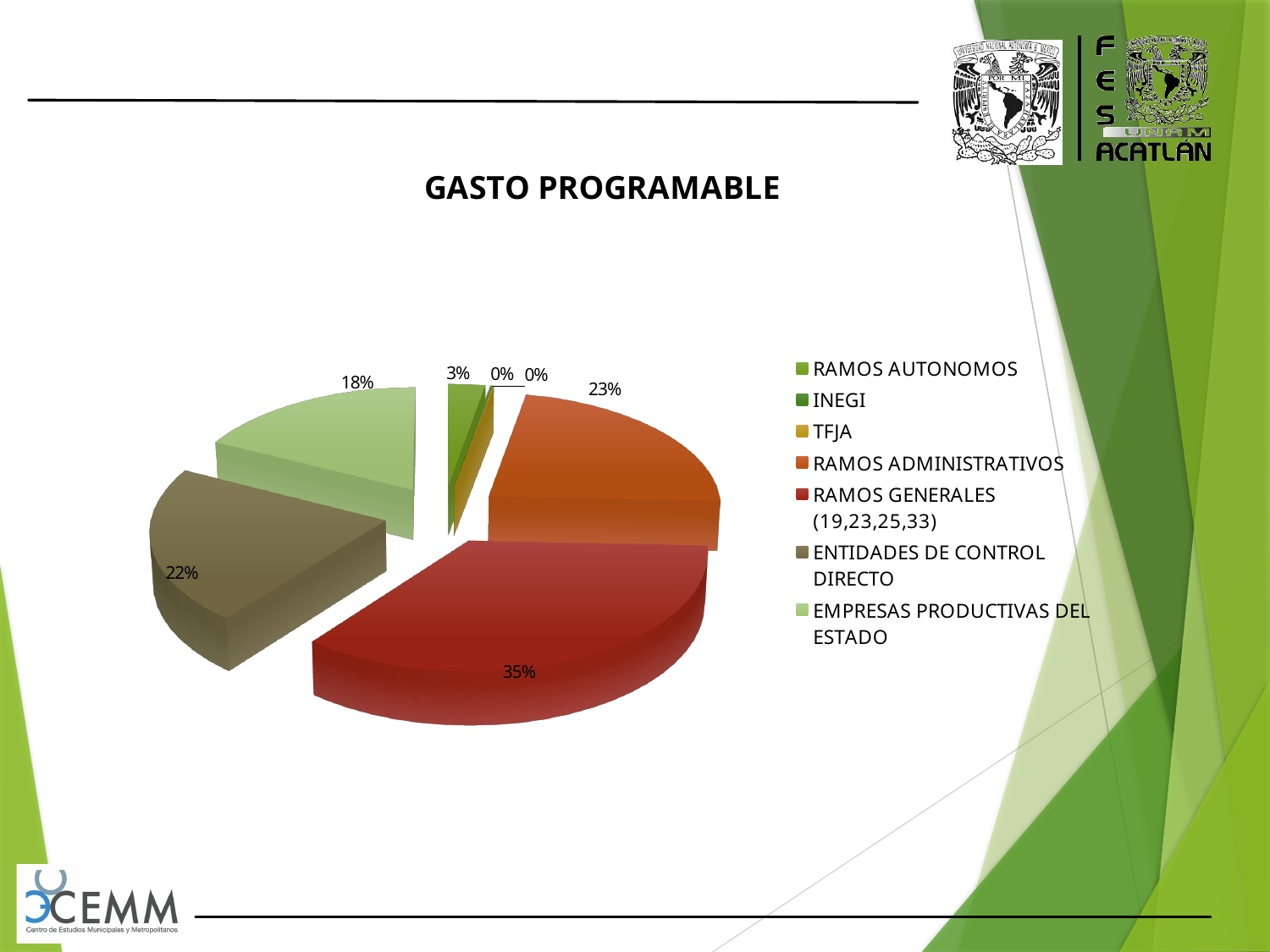
What share of the pie does EMPRESAS PRODUCTIVAS DEL ESTADO represent? 18% What share of the pie does RAMOS GENERALES (19,23,25,33) represent? 35% What is the title of the chart? GASTO PROGRAMABLE Which category has the largest share of the pie? RAMOS GENERALES (19,23,25,33) What is the difference in percentage points between RAMOS GENERALES (19,23,25,33) and RAMOS ADMINISTRATIVOS? 12 What share of the pie does RAMOS AUTONOMOS represent? 3% How many categories does the legend of the pie chart list? 7 Which is larger, the share for ENTIDADES DE CONTROL DIRECTO or the share for EMPRESAS PRODUCTIVAS DEL ESTADO? ENTIDADES DE CONTROL DIRECTO What kind of chart is shown on the slide? pie chart